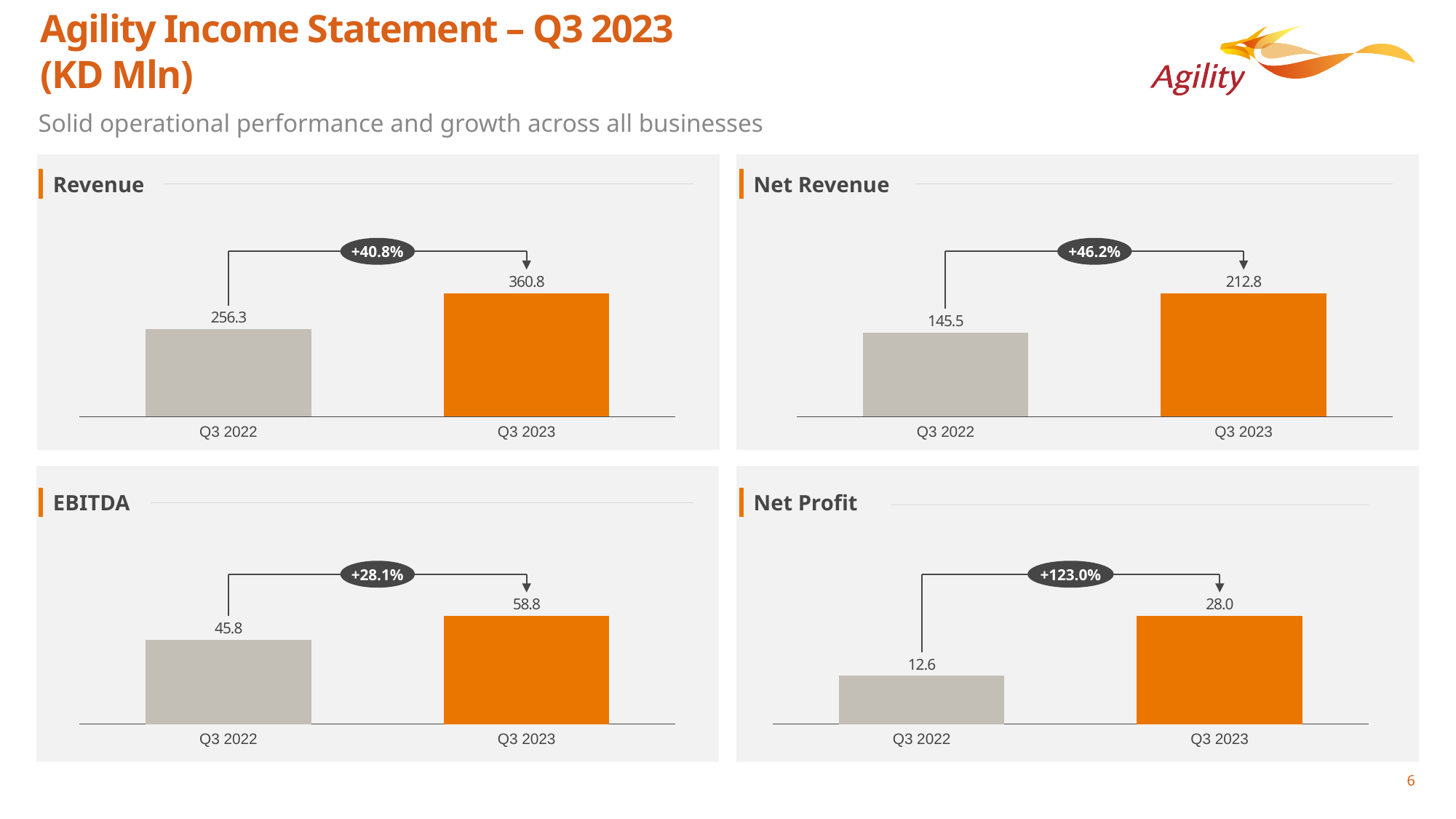
What percentage change is shown in the Net Profit chart between Q3 2022 and Q3 2023? +123.0% In the EBITDA chart, what is the difference between the Q3 2023 and Q3 2022 values? 13.0 How many bars are shown in the EBITDA chart? 2 In the Revenue chart, what is the value for Q3 2022? 256.3 In the Net Revenue chart, what is the value for Q3 2022? 145.5 In the EBITDA chart, what is the value for Q3 2023? 58.8 In the Net Profit chart, what is the value for Q3 2022? 12.6 What kind of chart is the Net Revenue chart? Bar chart In the Net Revenue chart, what is the value for Q3 2023? 212.8 In the Net Profit chart, what is the difference between the Q3 2023 and Q3 2022 values? 15.4 In the Revenue chart, what is the value for Q3 2023? 360.8 In the Revenue chart, which period has the higher value, Q3 2022 or Q3 2023? Q3 2023